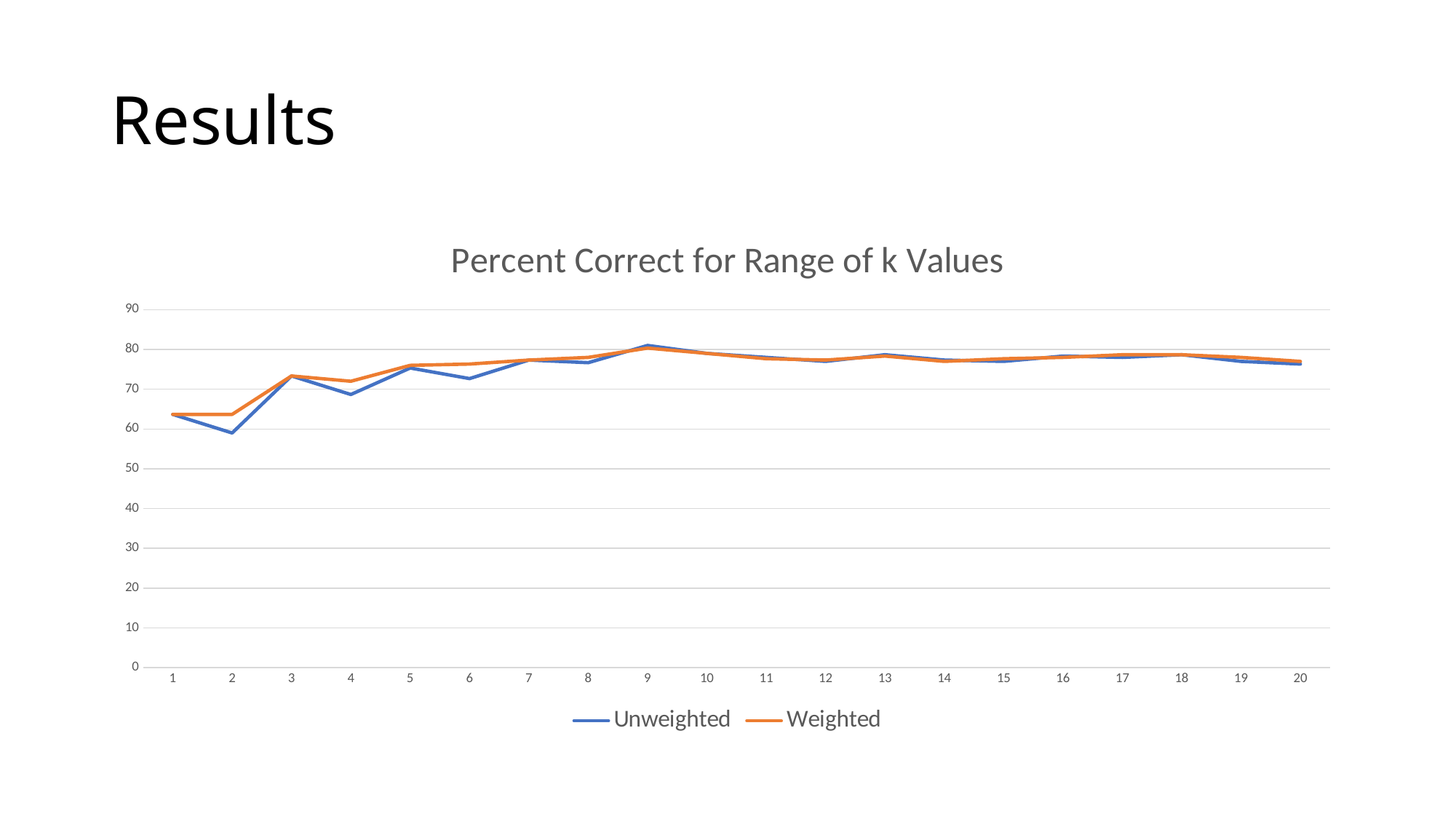
What kind of chart is shown on the slide? line chart How many k values are plotted along the x axis? 20 Is the Weighted value at k = 2 greater or less than 60? greater Which series is drawn in orange? Weighted How many series does the legend list? 2 At k = 2, which series has the higher value, Unweighted or Weighted? Weighted Between k = 1 and k = 3, does the Weighted line rise or fall? rise What is the title of the chart? Percent Correct for Range of k Values At which k value is the Unweighted series lowest? 2